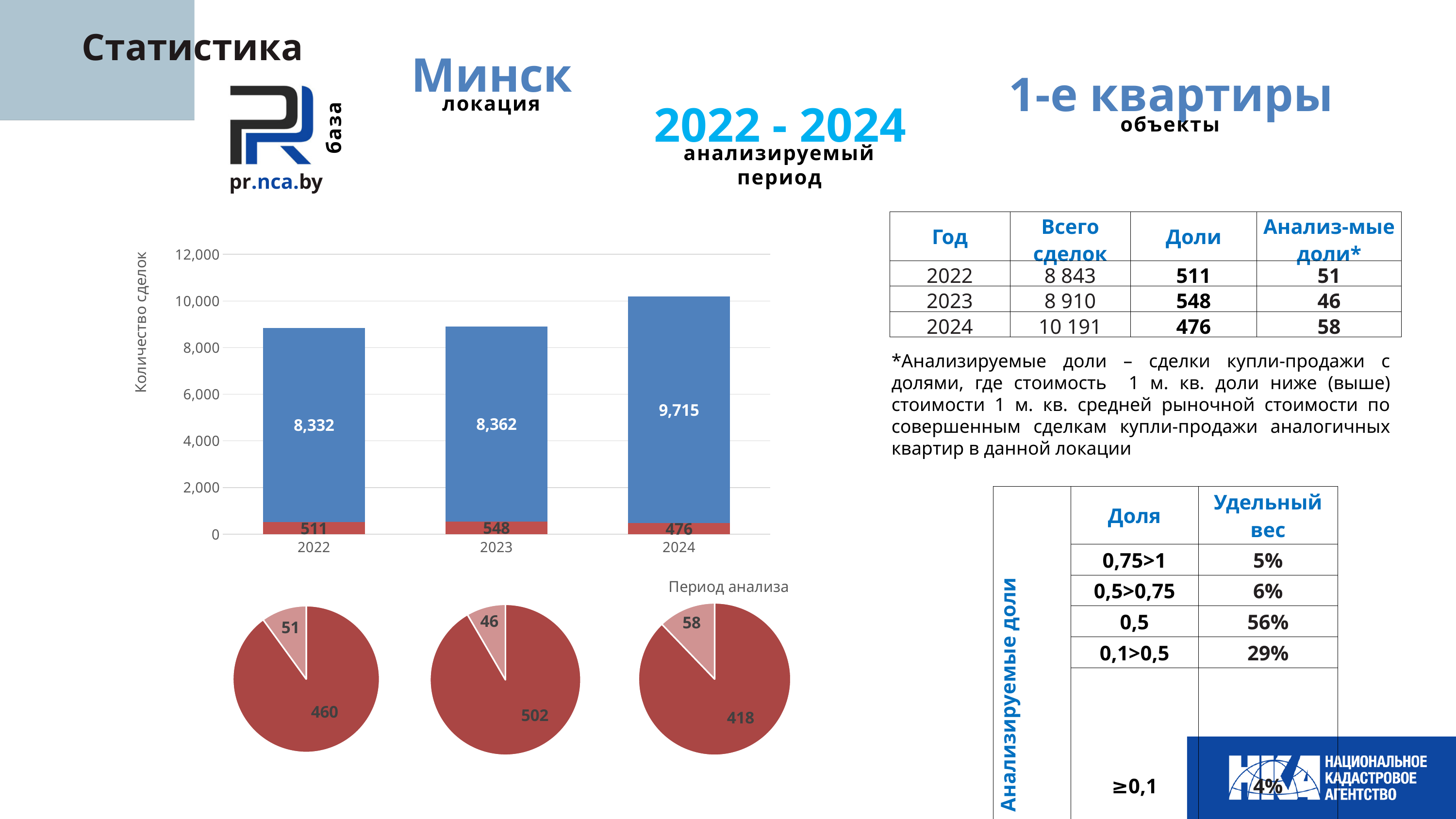
How many years are shown on the x axis of the bar chart? 3 What kind of chart is the large chart on the left of the slide showing 2022, 2023 and 2024? bar chart In the bar chart, what is the value of the red segment for 2023? 548 In the leftmost pie chart (2022), what is the value of the large dark red slice? 460 In the bar chart, what is the value of the blue segment for 2024? 9,715 In the bar chart, which year has the highest blue segment value? 2024 In the bar chart, which year has the lowest red segment value? 2024 In the bar chart, what is the difference between the blue segment values for 2024 and 2022? 1,383 In the bar chart, what is the total of the stacked bar for 2024? 10,191 In the bar chart, do the blue segment values rise or fall from 2022 to 2024? rise In the rightmost pie chart (2024), what is the value of the small light slice? 58 Which is larger: the small slice of the middle pie chart (2023) or the small slice of the rightmost pie chart (2024)? 2024